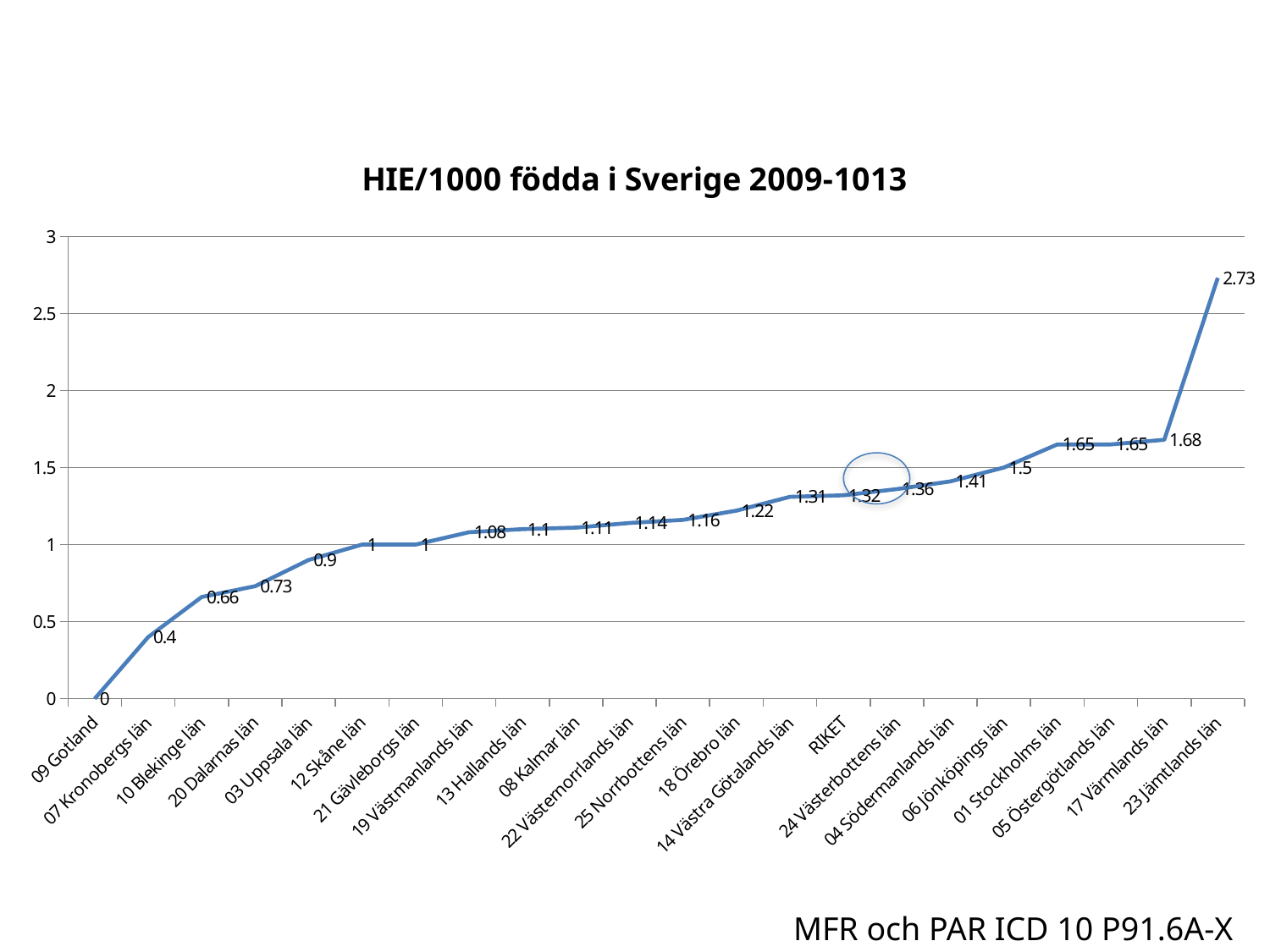
Do the values rise or fall from left to right along the x axis? Rise What is the value for RIKET? 1.32 Which category has the highest value? 23 Jämtlands län Which category has the lowest value? 09 Gotland What is the value for 03 Uppsala län? 0.9 What is the difference between the values for 23 Jämtlands län and 17 Värmlands län? 1.05 What type of chart is shown on the slide? Line chart What is the value for 06 Jönköpings län? 1.5 What is the title of the chart? HIE/1000 födda i Sverige 2009-1013 What is the value for 23 Jämtlands län? 2.73 How many categories are plotted along the x axis? 22 Which has a larger value, 10 Blekinge län or 20 Dalarnas län? 20 Dalarnas län